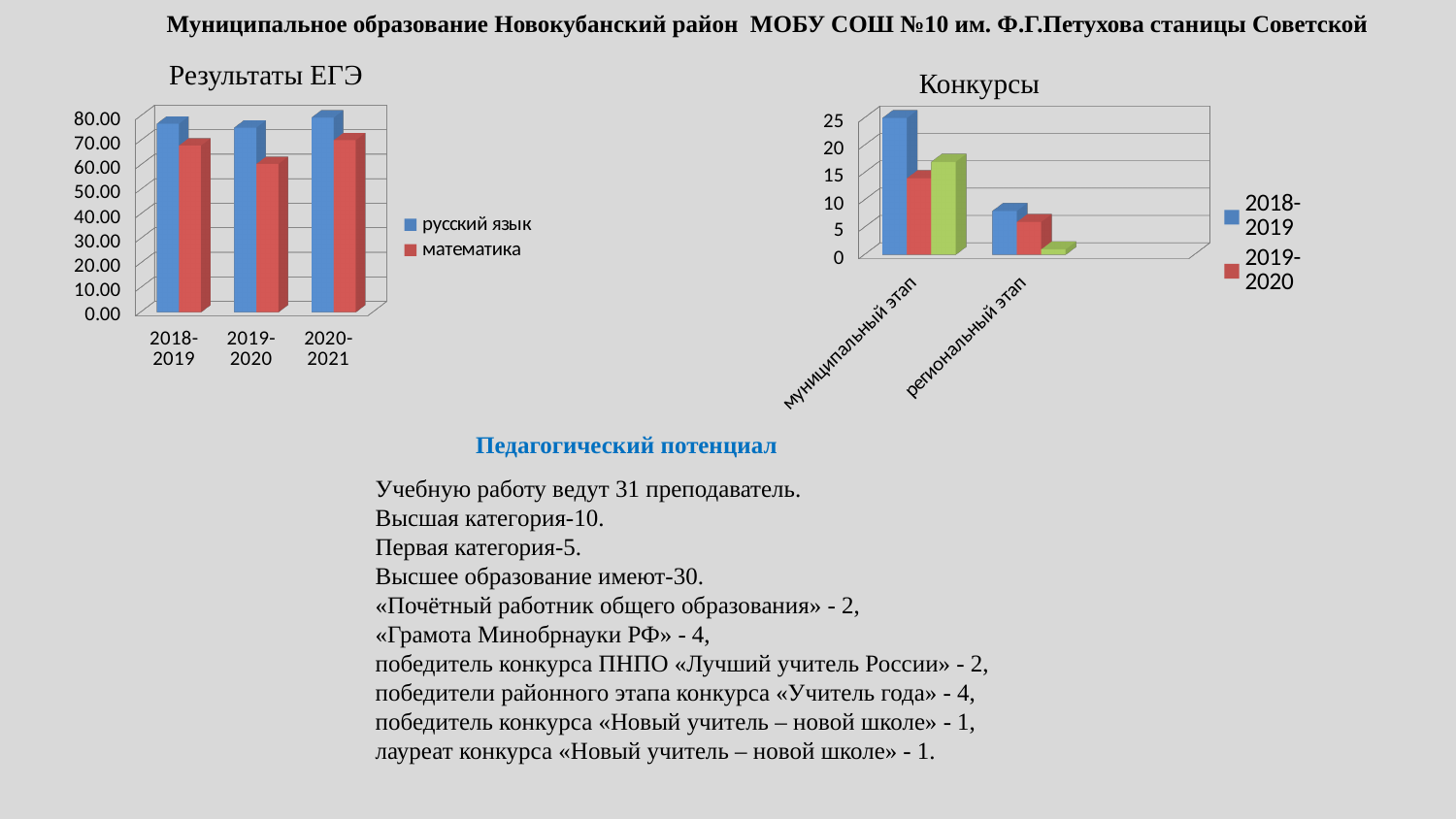
In the 'Конкурсы' chart, is the value for 2018-2019 at муниципальный этап greater or less than 20? greater How many series does the legend of the 'Результаты ЕГЭ' chart list? 2 In the 'Результаты ЕГЭ' chart, is the value for русский язык in 2018-2019 greater or less than 70.00? greater How many categories are shown on the x axis of the 'Конкурсы' chart? 2 What kind of chart is the 'Результаты ЕГЭ' chart? bar chart In the 'Результаты ЕГЭ' chart, which series has the larger value in 2019-2020, русский язык or математика? русский язык How many school-year categories are shown on the x axis of the 'Результаты ЕГЭ' chart? 3 In the 'Конкурсы' chart, is the value for 2019-2020 at региональный этап greater or less than 10? less In the 'Результаты ЕГЭ' chart, in which school year is the математика value lowest? 2019-2020 How many entries does the legend of the 'Конкурсы' chart list? 2 What is the title of the chart on the left of the slide? Результаты ЕГЭ